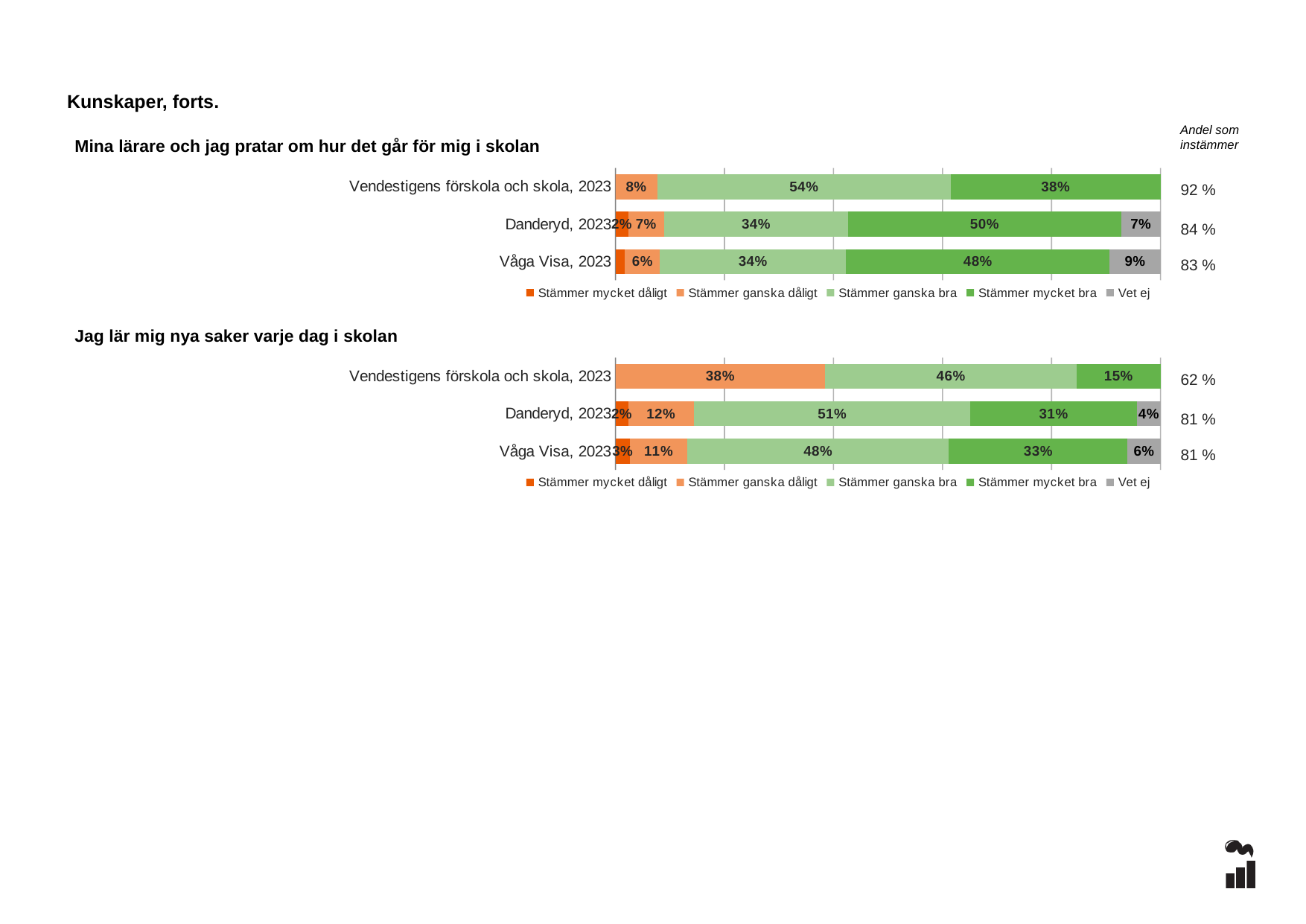
What type of chart is 'Mina lärare och jag pratar om hur det går för mig i skolan'? Stacked bar chart In the chart 'Jag lär mig nya saker varje dag i skolan', what is the 'Andel som instämmer' for Vendestigens förskola och skola, 2023? 62 % In the chart 'Mina lärare och jag pratar om hur det går för mig i skolan', what percentage of Danderyd, 2023 answered 'Stämmer mycket bra'? 50% In the chart 'Mina lärare och jag pratar om hur det går för mig i skolan', what is the 'Vet ej' share for Våga Visa, 2023? 9% How many series does the legend of the chart 'Jag lär mig nya saker varje dag i skolan' list? 5 In the chart 'Jag lär mig nya saker varje dag i skolan', which row has the lowest 'Andel som instämmer'? Vendestigens förskola och skola, 2023 In the chart 'Mina lärare och jag pratar om hur det går för mig i skolan', what is the difference between the 'Stämmer mycket bra' shares of Danderyd, 2023 and Vendestigens förskola och skola, 2023? 12% In the chart 'Jag lär mig nya saker varje dag i skolan', what is the difference between the 'Stämmer mycket bra' shares of Våga Visa, 2023 and Danderyd, 2023? 2% In the chart 'Mina lärare och jag pratar om hur det går för mig i skolan', which row has the highest 'Andel som instämmer'? Vendestigens förskola och skola, 2023 In the chart 'Jag lär mig nya saker varje dag i skolan', what percentage of Vendestigens förskola och skola, 2023 answered 'Stämmer ganska dåligt'? 38% In the chart 'Mina lärare och jag pratar om hur det går för mig i skolan', what percentage of Vendestigens förskola och skola, 2023 answered 'Stämmer ganska bra'? 54% In the chart 'Jag lär mig nya saker varje dag i skolan', which is larger: the 'Stämmer ganska bra' share for Danderyd, 2023 or for Våga Visa, 2023? Danderyd, 2023